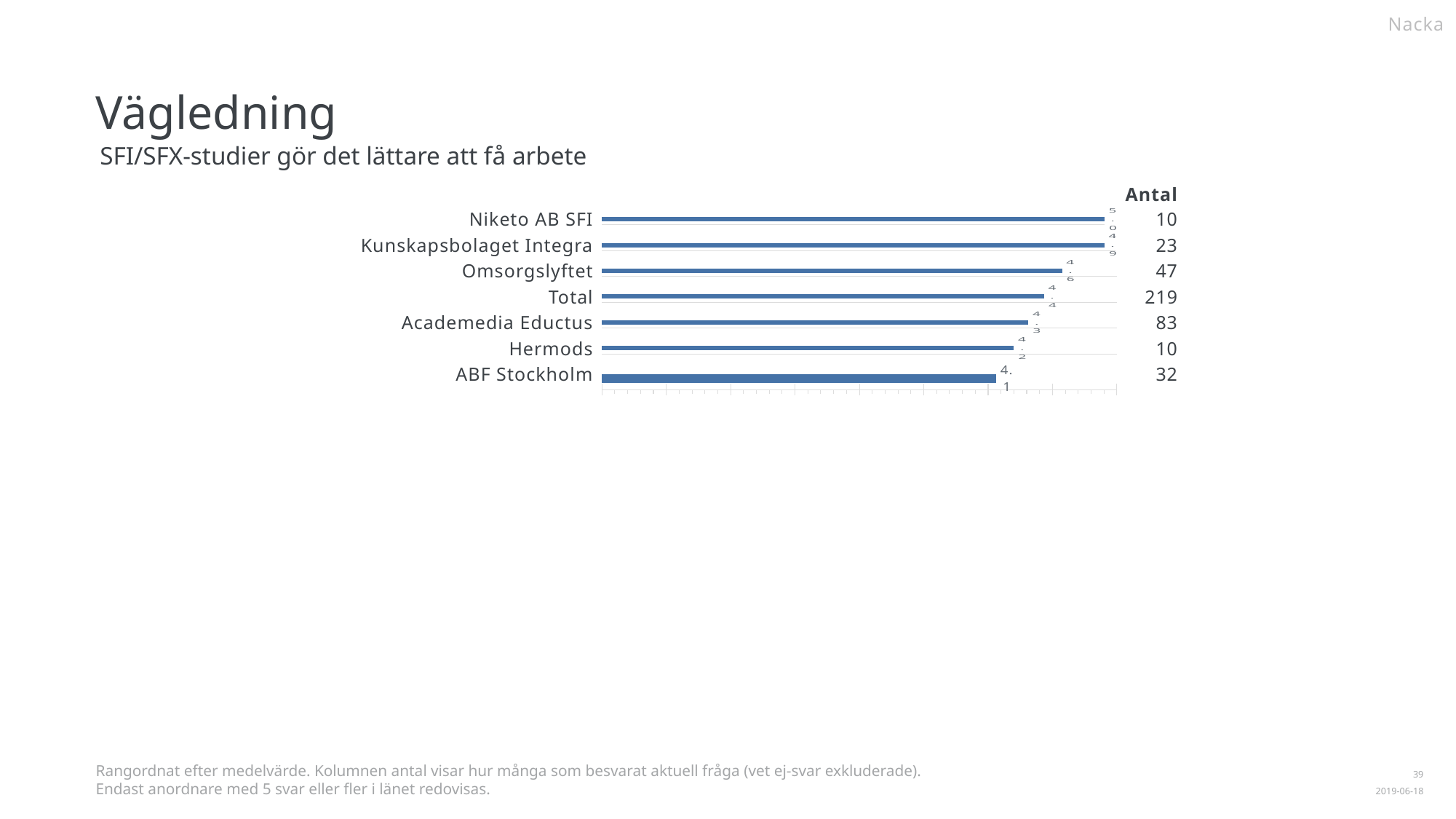
What is the heading of the numeric column to the right of the bars? Antal What is the Antal value shown for Academedia Eductus? 83 What kind of chart is shown on the slide? Bar chart What is the subtitle (question text) shown above the chart? SFI/SFX-studier gör det lättare att få arbete How many categories (bars) does the chart show? 7 What is the data label value for ABF Stockholm? 4.1 What is the Antal value shown for Total? 219 Which category has the shortest bar in the chart? ABF Stockholm Is the bar for Academedia Eductus longer or shorter than the bar for Kunskapsbolaget Integra? Shorter Which category has the longest bar in the chart? Niketo AB SFI Is the bar for Omsorgslyftet longer or shorter than the bar for Hermods? Longer What is the data label value for Niketo AB SFI? 5.0